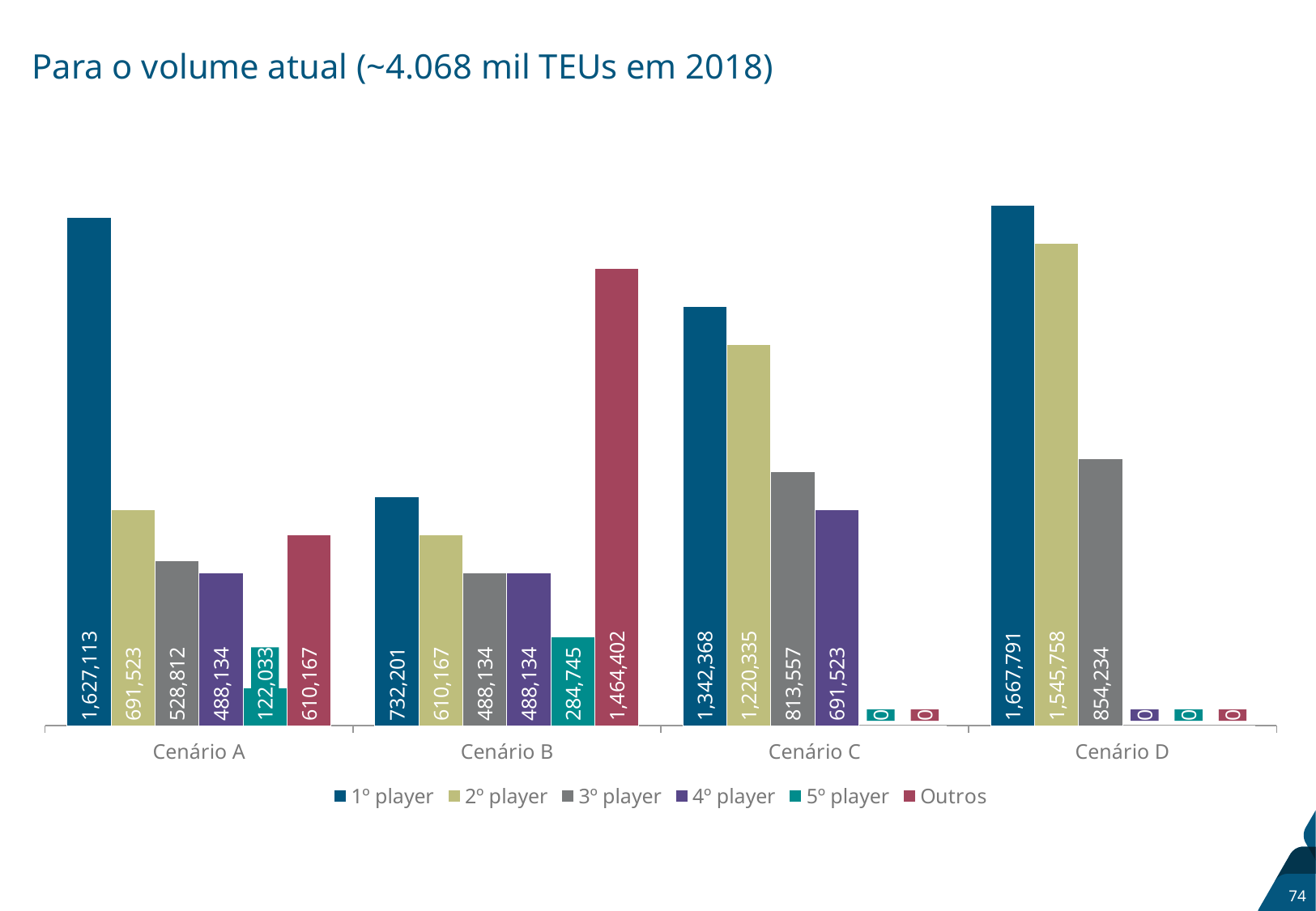
Which series has the highest value in Cenário B? Outros What is the title of the slide? Para o volume atual (~4.068 mil TEUs em 2018) What is the value for 3º player in Cenário D? 854,234 How many series does the legend list? 6 What is the value for 1º player in Cenário A? 1,627,113 What is the value for 5º player in Cenário B? 284,745 What is the value for Outros in Cenário B? 1,464,402 What kind of chart is shown on the slide? Bar chart How many scenarios (categories) are shown on the x axis? 4 Which series has the lowest value in Cenário A? 5º player What is the difference between the 1º player and 2º player values in Cenário D? 122,033 Which is larger: the 2º player value in Cenário C or the 2º player value in Cenário A? Cenário C